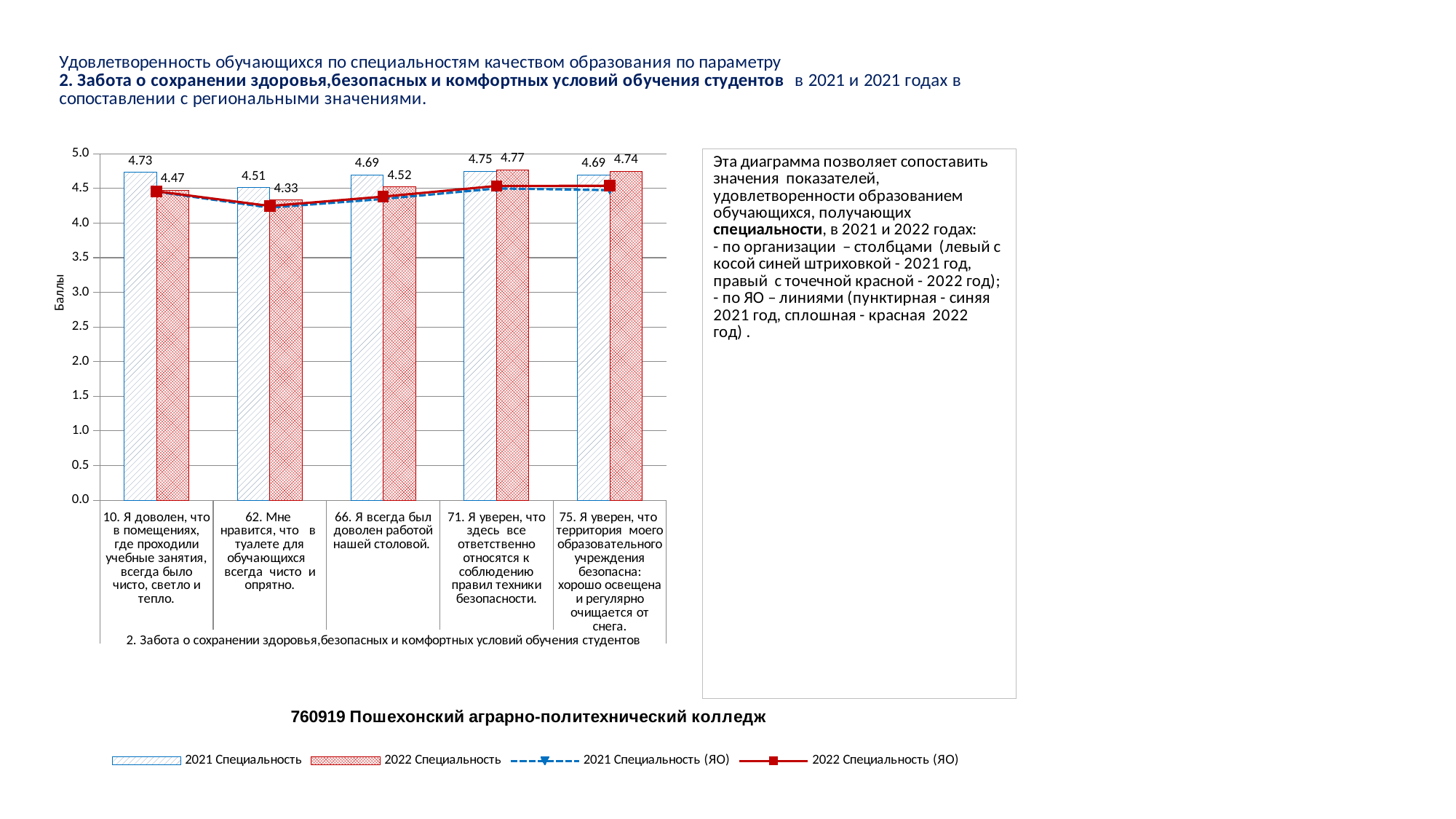
What is the value of the 2021 Специальность bar for category 66 (Я всегда был доволен работой нашей столовой)? 4.69 What is the label of the vertical axis of the chart? Баллы How many series does the chart legend list? 4 What is the value of the 2022 Специальность bar for category 62 (Мне нравится, что в туалете для обучающихся всегда чисто и опрятно)? 4.33 Which category has the highest 2022 Специальность value? 71. Я уверен, что здесь все ответственно относятся к соблюдению правил техники безопасности. Which category has the lowest 2022 Специальность value? 62. Мне нравится, что в туалете для обучающихся всегда чисто и опрятно. What is the value of the 2022 Специальность bar for category 71 (Я уверен, что здесь все ответственно относятся к соблюдению правил техники безопасности)? 4.77 What is the value of the 2021 Специальность bar for category 10 (Я доволен, что в помещениях, где проходили учебные занятия, всегда было чисто, светло и тепло)? 4.73 How many categories (questions) are shown on the x axis of the chart? 5 Is the 2022 Специальность (ЯО) line value for category 62 greater or less than 4.5? less What is the difference between the 2021 and 2022 Специальность values for category 10? 0.26 For category 75 (Я уверен, что территория моего образовательного учреждения безопасна), which is larger: the 2021 Специальность value or the 2022 Специальность value? 2022 Специальность